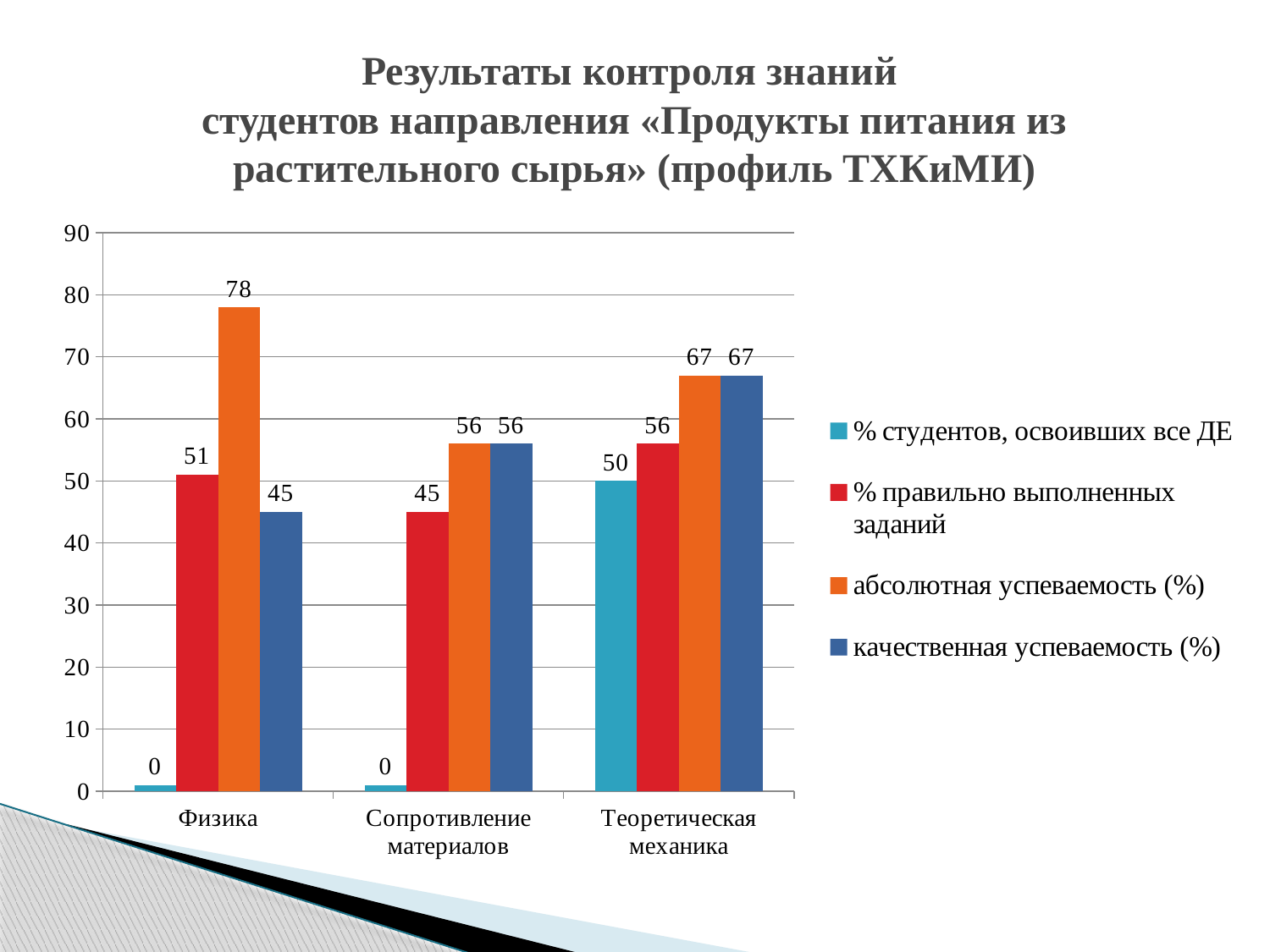
What kind of chart is shown on the slide? Bar chart Which category has the lowest value for «качественная успеваемость (%)»? Физика What is the value of «% правильно выполненных заданий» for Сопротивление материалов? 45 How many series does the legend list? 4 What is the value of «% студентов, освоивших все ДЕ» for Теоретическая механика? 50 Which category has the highest value for «абсолютная успеваемость (%)»? Физика What is the value of «качественная успеваемость (%)» for Физика? 45 Which colour represents «абсолютная успеваемость (%)» in the legend? Orange How many categories are shown on the x axis? 3 What is the difference between «абсолютная успеваемость (%)» for Физика and for Теоретическая механика? 11 Which is larger: «% правильно выполненных заданий» for Физика or for Теоретическая механика? Теоретическая механика What is the value of «абсолютная успеваемость (%)» for Физика? 78